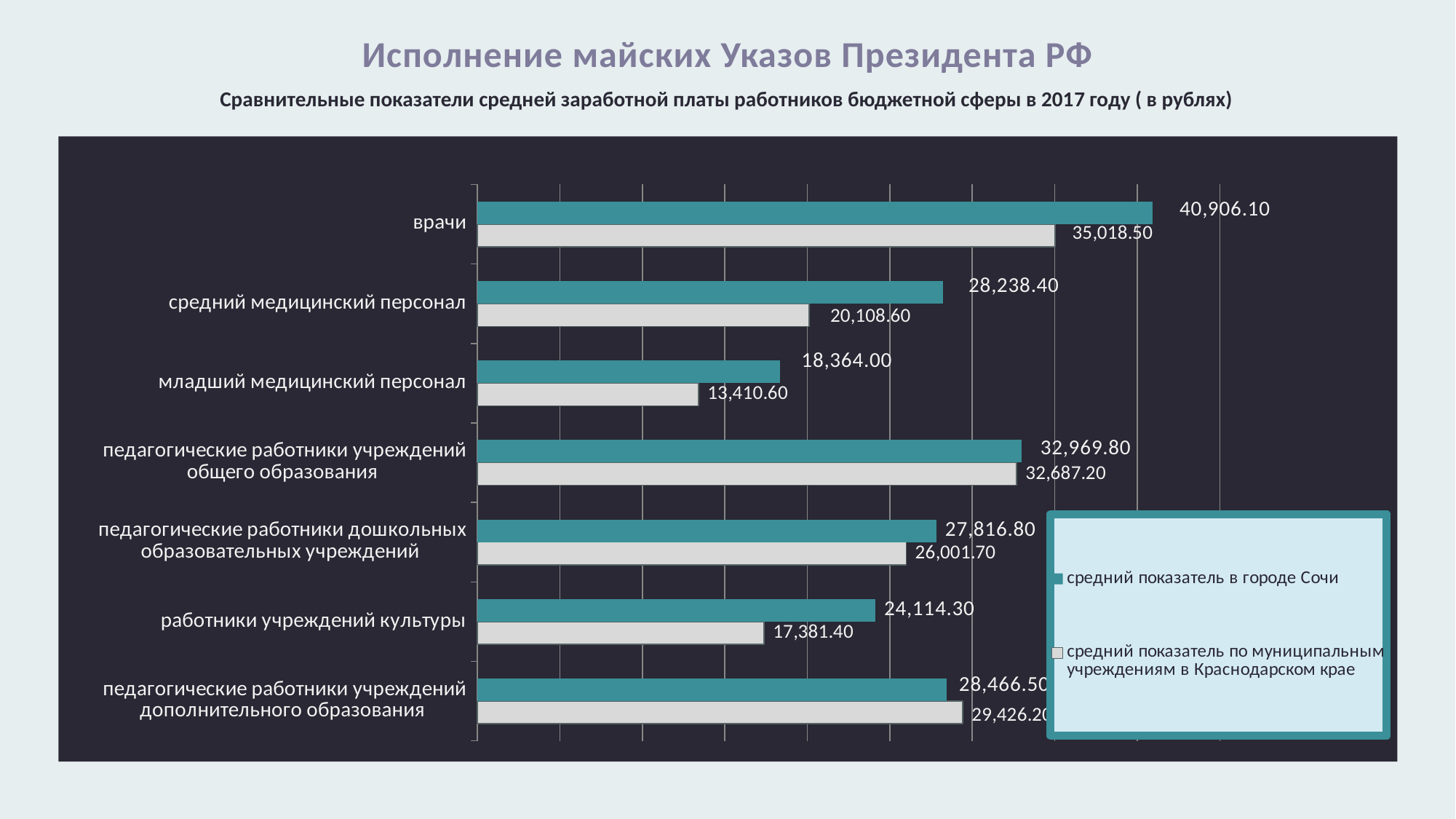
For средний медицинский персонал, what is the difference between the Сочи value and the Краснодарский край value? 8,129.80 What kind of chart is shown on the slide? bar chart For врачи, what is the difference between the Сочи value and the Краснодарский край value? 5,887.60 Which category has the highest value in the series 'средний показатель в городе Сочи'? врачи What is the value for врачи in the series 'средний показатель в городе Сочи'? 40,906.10 What is the value for младший медицинский персонал in the series 'средний показатель в городе Сочи'? 18,364.00 How many categories (job groups) are plotted on the chart? 7 For педагогические работники учреждений дополнительного образования, which series has the larger value: Сочи or Краснодарский край? Краснодарский край How many series does the legend list? 2 Which colour represents the series 'средний показатель в городе Сочи' in the legend? teal What is the value for работники учреждений культуры in the series 'средний показатель по муниципальным учреждениям в Краснодарском крае'? 17,381.40 Which category has the lowest value in the series 'средний показатель по муниципальным учреждениям в Краснодарском крае'? младший медицинский персонал